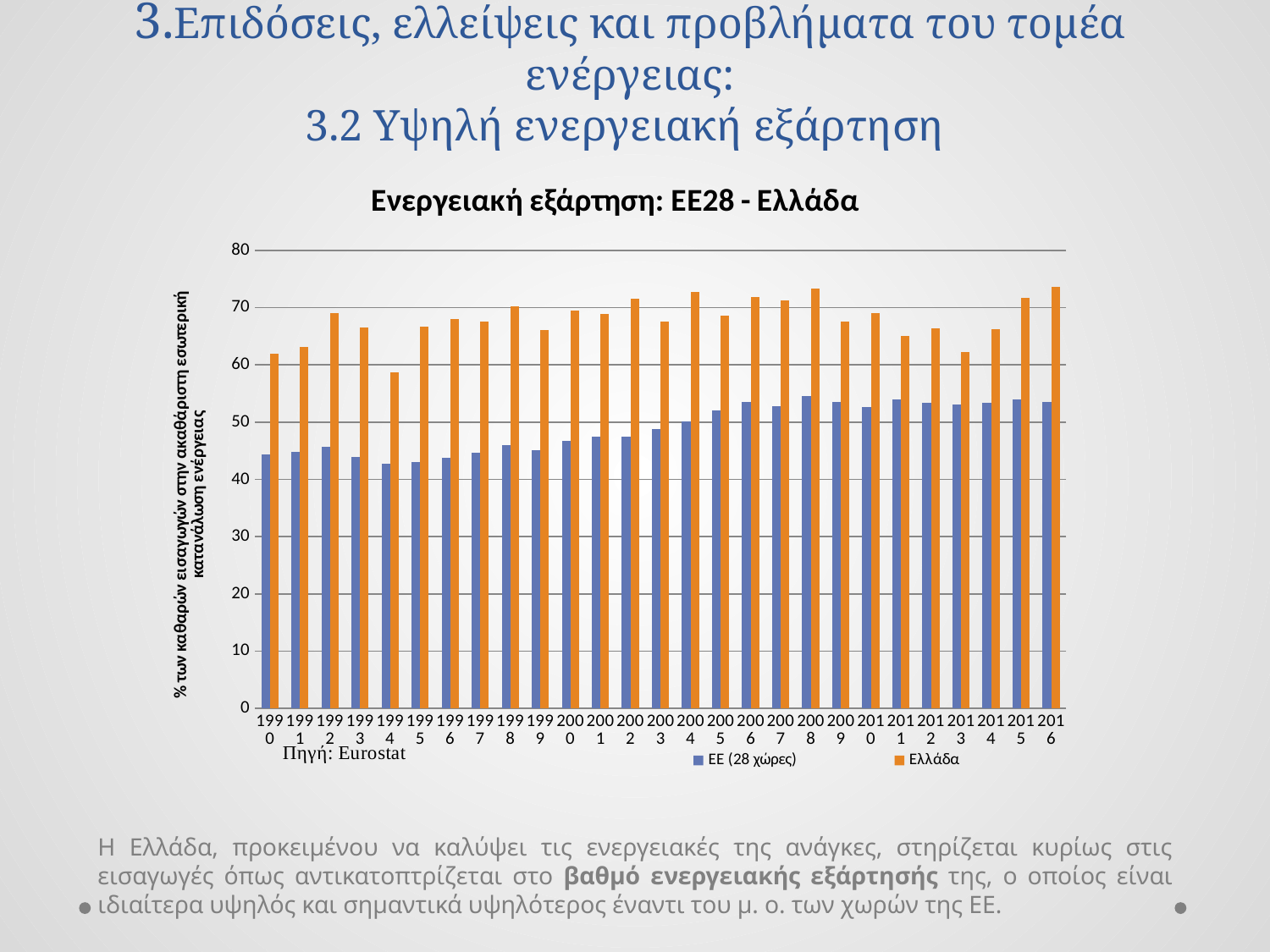
Is the value for Ελλάδα in 2004 greater or less than 70? greater Which series is shown in orange in the chart? Ελλάδα What kind of chart is shown on the slide? bar chart Is the value for ΕΕ (28 χώρες) in 2008 greater or less than 50? greater How many years are shown on the x axis of the chart? 27 What is the title of the chart? Ενεργειακή εξάρτηση: ΕΕ28 - Ελλάδα In which year is the value for Ελλάδα lowest? 1994 Which series has the larger value in 2000, ΕΕ (28 χώρες) or Ελλάδα? Ελλάδα Is the value for Ελλάδα in 2016 greater or less than 70? greater How many series does the legend list? 2 Does the value for ΕΕ (28 χώρες) generally rise or fall from 1990 to 2016? rise